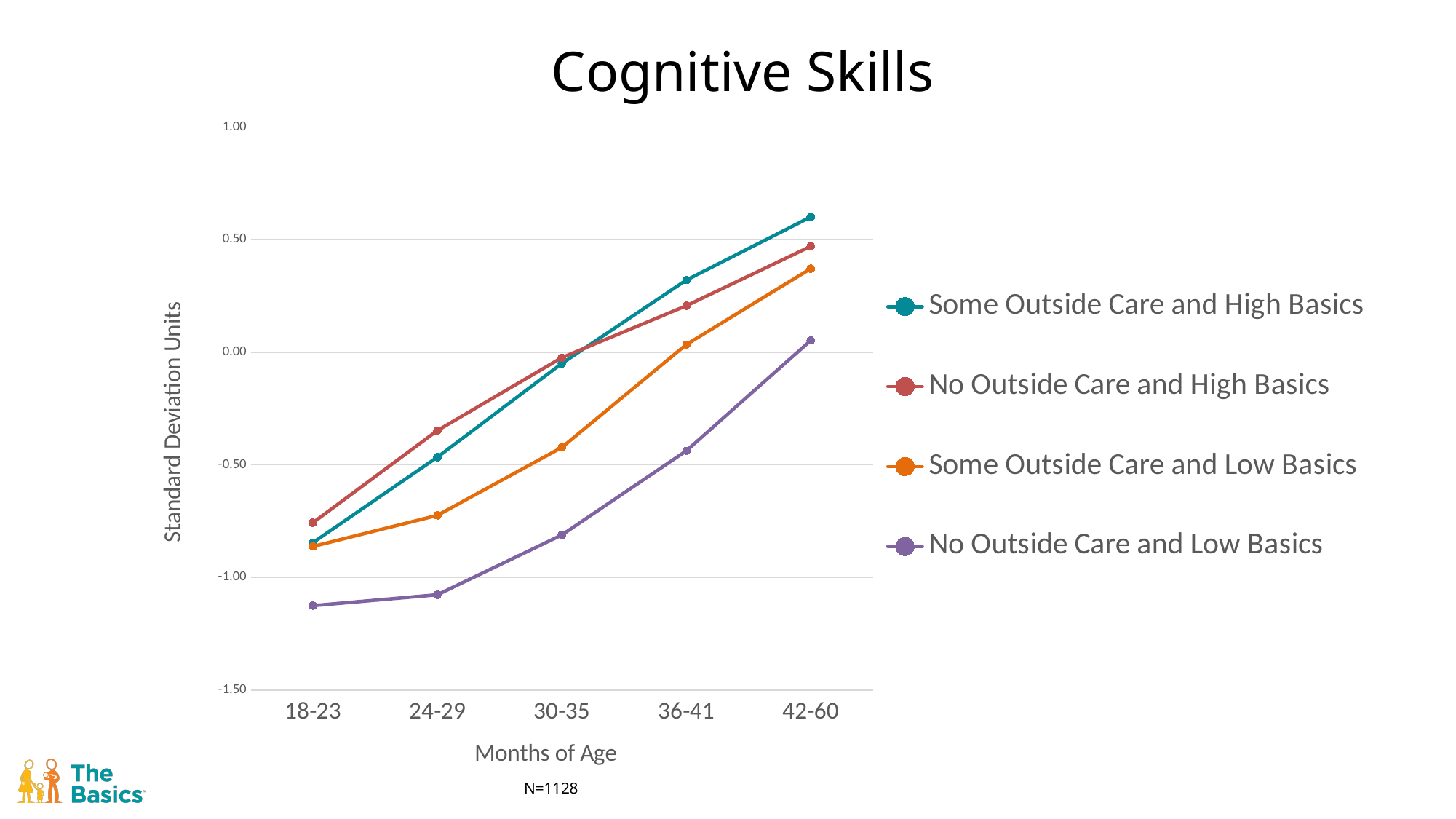
Is the value for Some Outside Care and High Basics at 42-60 months greater or less than 0.50? greater Is the value for Some Outside Care and Low Basics at 24-29 months greater or less than -0.50? less What is the title of the y axis? Standard Deviation Units Do the values for Some Outside Care and High Basics rise or fall from 18-23 to 42-60 months? rise At 36-41 months, which is larger: Some Outside Care and High Basics or No Outside Care and High Basics? Some Outside Care and High Basics Which series has the highest value at 42-60 months? Some Outside Care and High Basics How many age groups are shown on the x axis? 5 Is the value for No Outside Care and Low Basics at 18-23 months greater or less than -1.00? less Which series has the lowest value at 18-23 months? No Outside Care and Low Basics What kind of chart is shown on the slide? line chart What is the title of the x axis? Months of Age How many series does the legend list? 4